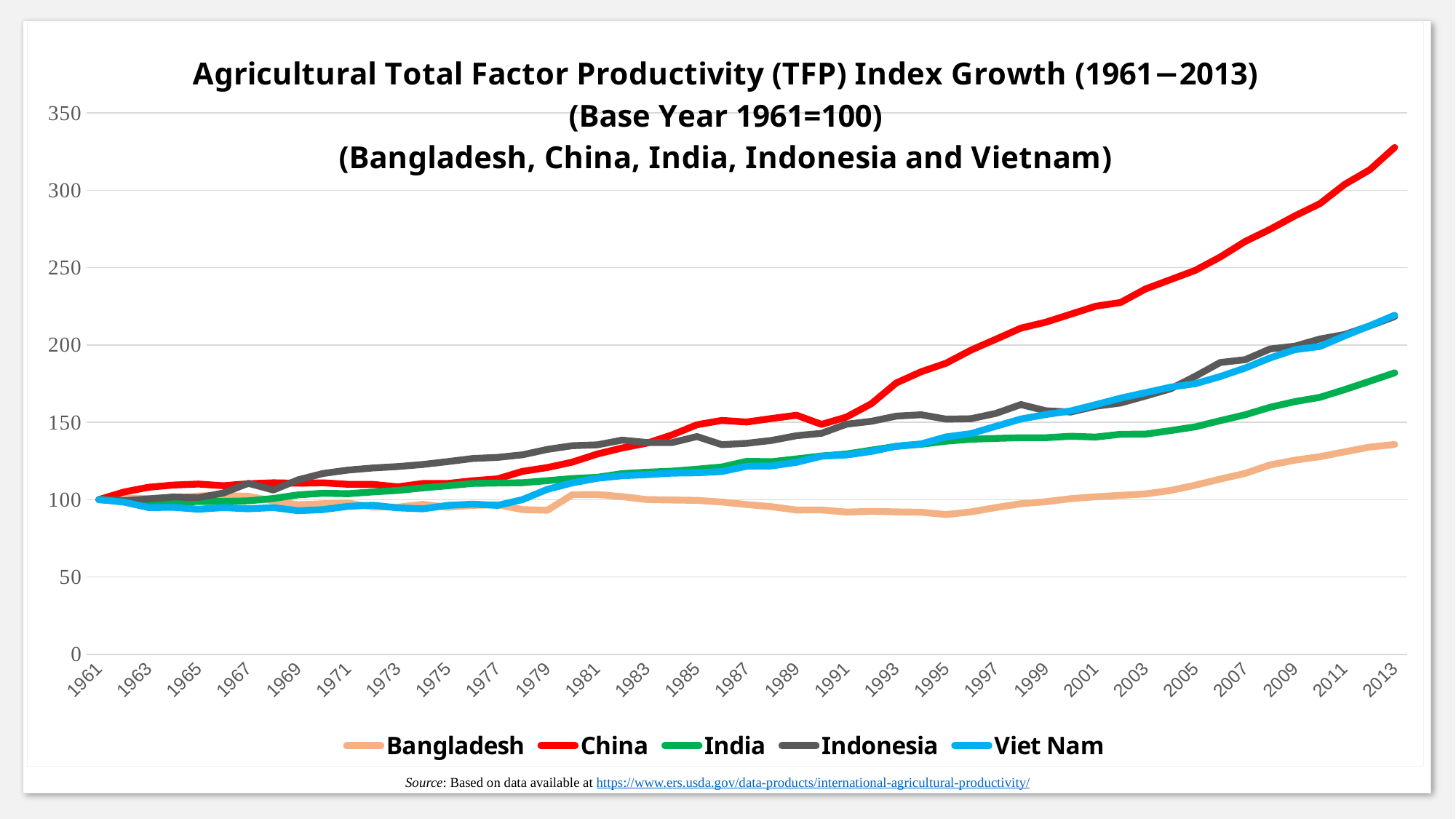
Is the value for Viet Nam in 2013 greater or less than 200? greater How many series does the legend list? 5 What colour is the line for China? red What kind of chart is shown on the slide? line chart Is the value for India in 2013 greater or less than 150? greater In 2013, which is larger: the value for India or the value for Indonesia? Indonesia Which country has the lowest TFP index value in 2013? Bangladesh Is the value for China in 2013 greater or less than 300? greater Which country has the highest TFP index value in 2013? China What is the TFP index value for every country in the base year 1961? 100 Does the China line rise or fall from 1961 to 2013? rise